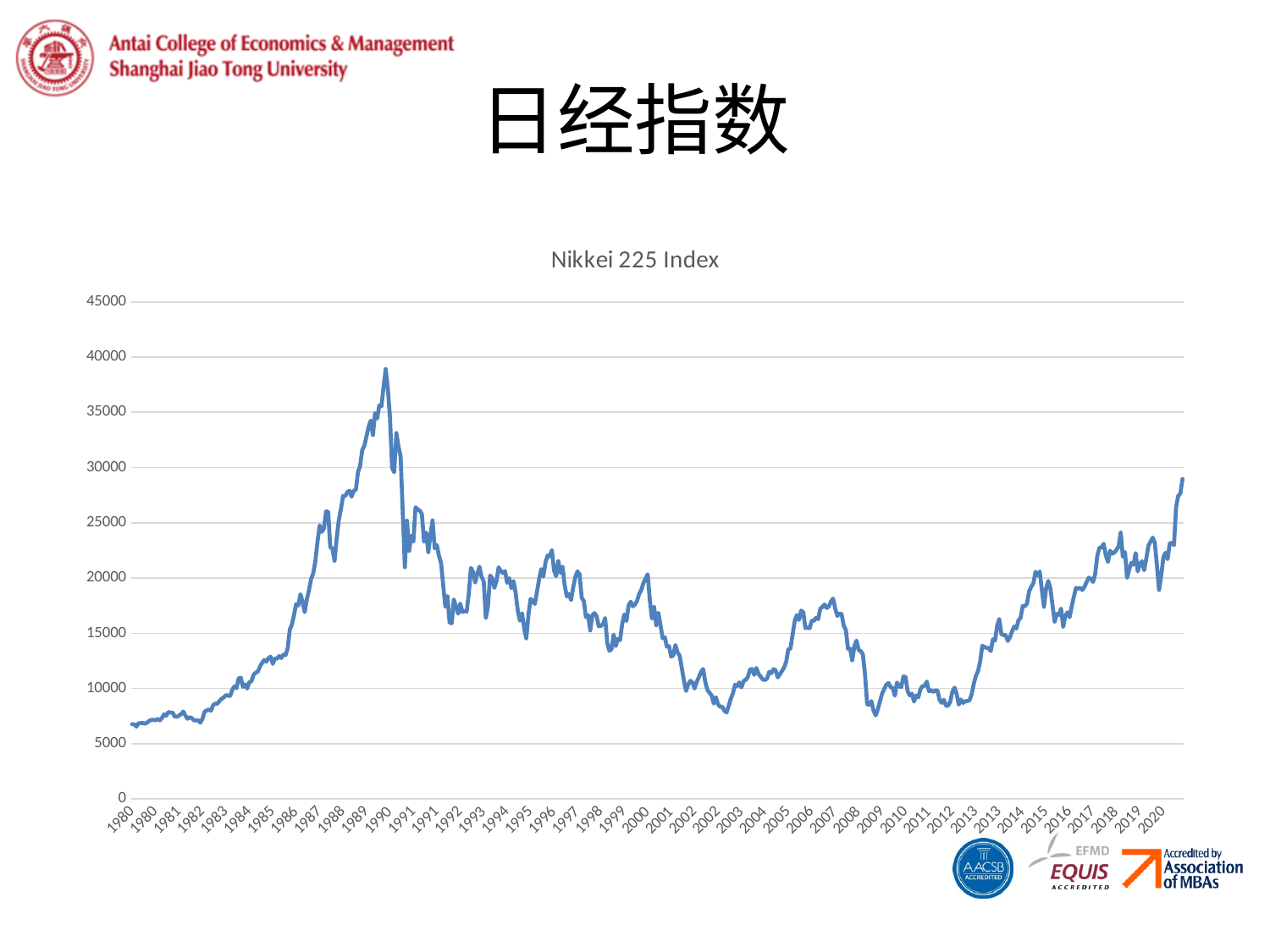
Is the peak value of the Nikkei 225 Index around 1989 greater or less than 35000? greater Is the lowest value of the Nikkei 225 Index in 2009 greater or less than 10000? less Is the value of the Nikkei 225 Index at the end of 2020 greater or less than 25000? greater Does the Nikkei 225 Index generally rise or fall from 1980 to 1989? rise What is the highest value shown on the vertical axis of the chart? 45000 Does the Nikkei 225 Index generally rise or fall from 1990 to 1992? fall What kind of chart is shown on the slide? line chart What is the title of the chart? Nikkei 225 Index Which is higher: the Nikkei 225 Index peak around 1989 or its value at the end of 2020? the peak around 1989 In which year does the Nikkei 225 Index reach its highest value on the chart? 1989